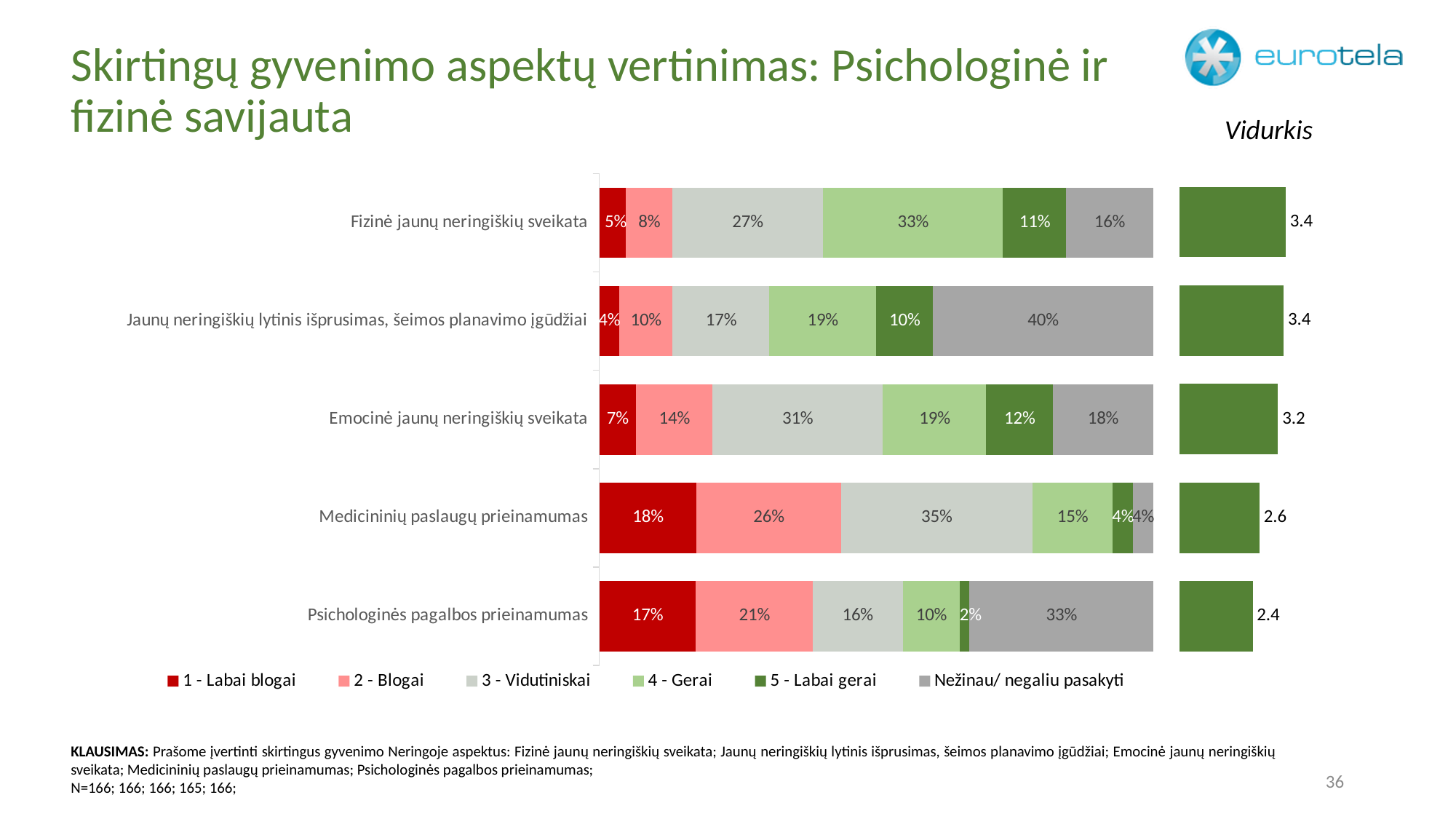
In the main stacked bar chart, which category has the highest '1 - Labai blogai' share? Medicininių paslaugų prieinamumas In the main stacked bar chart, what is the difference between the '3 - Vidutiniskai' shares for 'Medicininių paslaugų prieinamumas' and 'Psichologinės pagalbos prieinamumas'? 19% In the Vidurkis chart, which category has the lowest average? Psichologinės pagalbos prieinamumas In the main stacked bar chart, which category has the lowest '5 - Labai gerai' share? Psichologinės pagalbos prieinamumas In the Vidurkis chart, what is the average value for 'Emocinė jaunų neringiškių sveikata'? 3.2 How many series does the legend of the main stacked bar chart list? 6 In the main stacked bar chart, what percentage rated 'Medicininių paslaugų prieinamumas' as '1 - Labai blogai'? 18% What kind of chart is the main chart on the slide? Stacked bar chart In the main stacked bar chart, what percentage of respondents rated 'Fizinė jaunų neringiškių sveikata' as '4 - Gerai'? 33% In the main stacked bar chart, what is the 'Nežinau/ negaliu pasakyti' share for 'Jaunų neringiškių lytinis išprusimas, šeimos planavimo įgūdžiai'? 40% How many categories are shown in the main stacked bar chart? 5 In the main stacked bar chart, which is larger: the '2 - Blogai' share for 'Emocinė jaunų neringiškių sveikata' or for 'Fizinė jaunų neringiškių sveikata'? Emocinė jaunų neringiškių sveikata